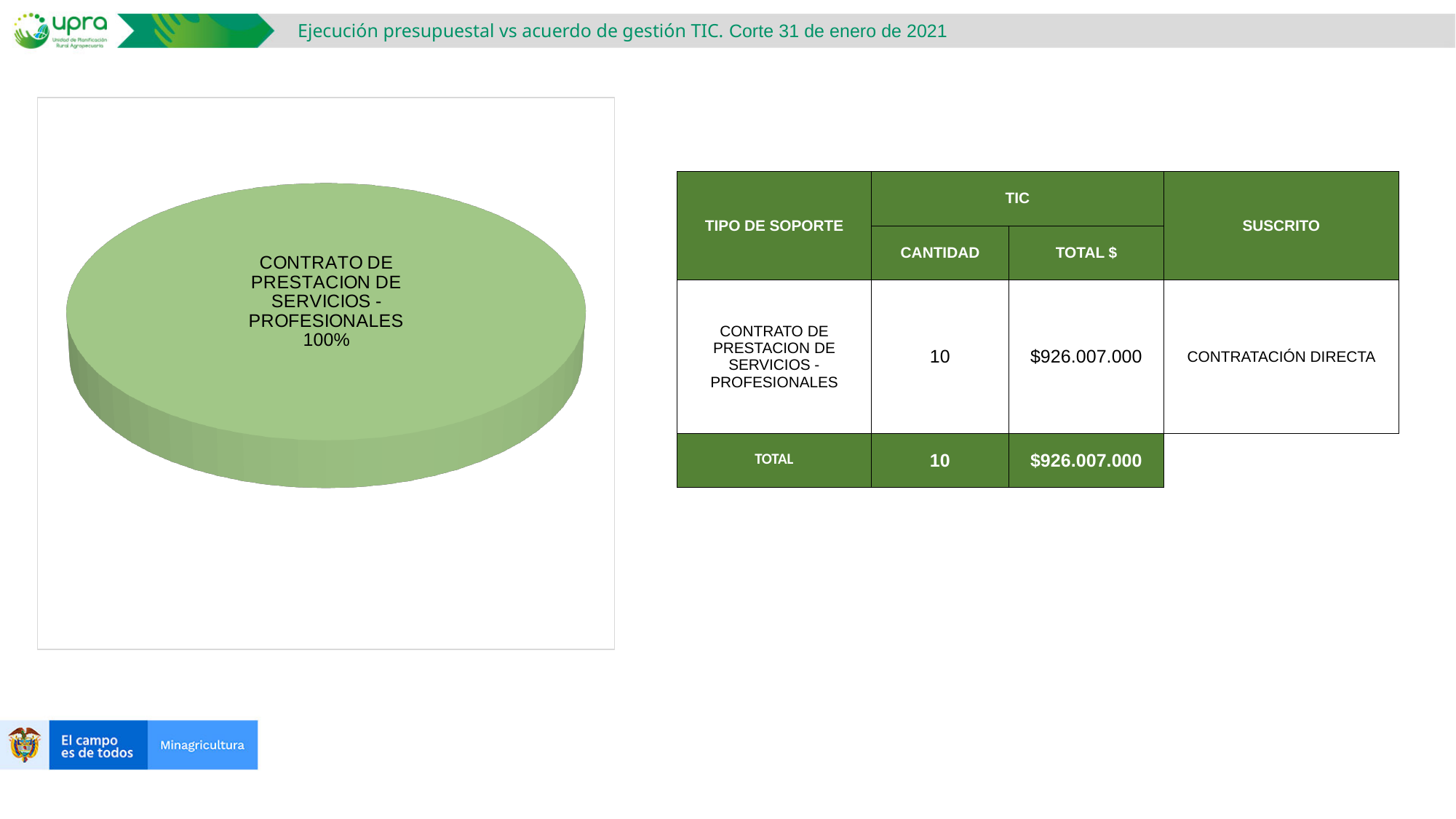
Is the share shown for CONTRATO DE PRESTACION DE SERVICIOS - PROFESIONALES in the pie chart greater or less than 50%? greater What colour is the single slice of the pie chart? green What share of the pie chart does CONTRATO DE PRESTACION DE SERVICIOS - PROFESIONALES represent? 100% What kind of chart is shown on the left of the slide? pie chart Which category is shown in the pie chart? CONTRATO DE PRESTACION DE SERVICIOS - PROFESIONALES How many slices does the pie chart have? 1